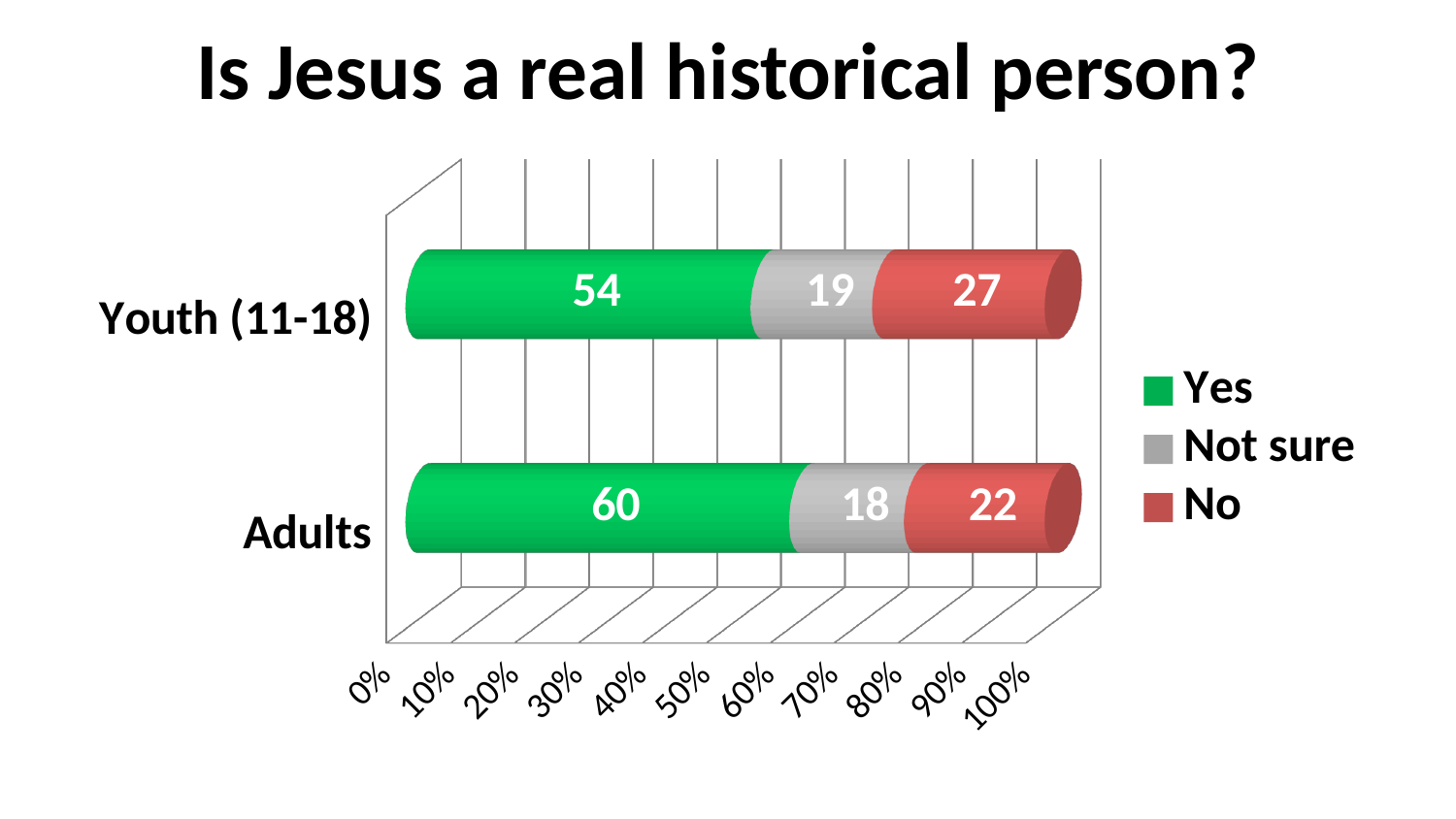
Which group has the higher "No" value, Youth (11-18) or Adults? Youth (11-18) Which group has the higher "Yes" value, Youth (11-18) or Adults? Adults What kind of chart is shown on the slide? Stacked bar chart How many categories (groups) are shown on the chart? 2 What is the value for "Yes" among Adults? 60 What is the difference between the "No" values for Youth (11-18) and Adults? 5 What is the total of the stacked bar for Adults? 100 How many series does the legend list? 3 What is the value for "Not sure" among Youth (11-18)? 19 What is the value for "Yes" among Youth (11-18)? 54 What is the value for "No" among Adults? 22 What is the difference between the "Yes" values for Adults and Youth (11-18)? 6